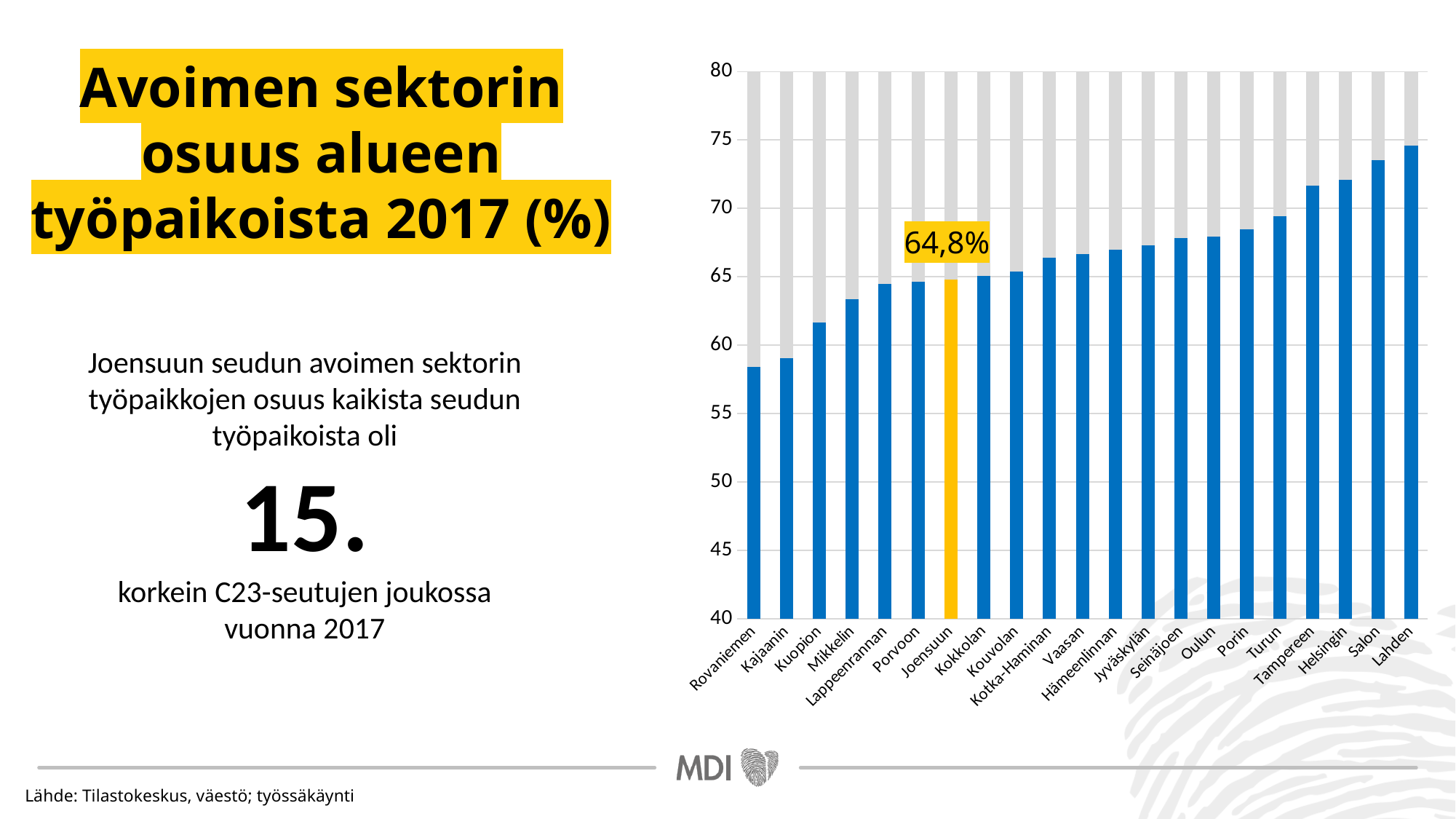
Do the values rise or fall from left to right along the x axis? rise Is the value for Kuopion greater or less than 60? greater Which is larger, the value for Helsingin or the value for Kajaanin? Helsingin Is the value for Tampereen greater or less than 70? greater What is the value shown for Joensuun? 64,8% Is the value for Rovaniemen greater or less than 60? less Which bar is highlighted in yellow in the chart? Joensuun Which region has the lowest value in the chart? Rovaniemen What kind of chart is shown on the slide? bar chart How many regions (bars) are shown in the chart? 21 Which region has the highest value in the chart? Lahden